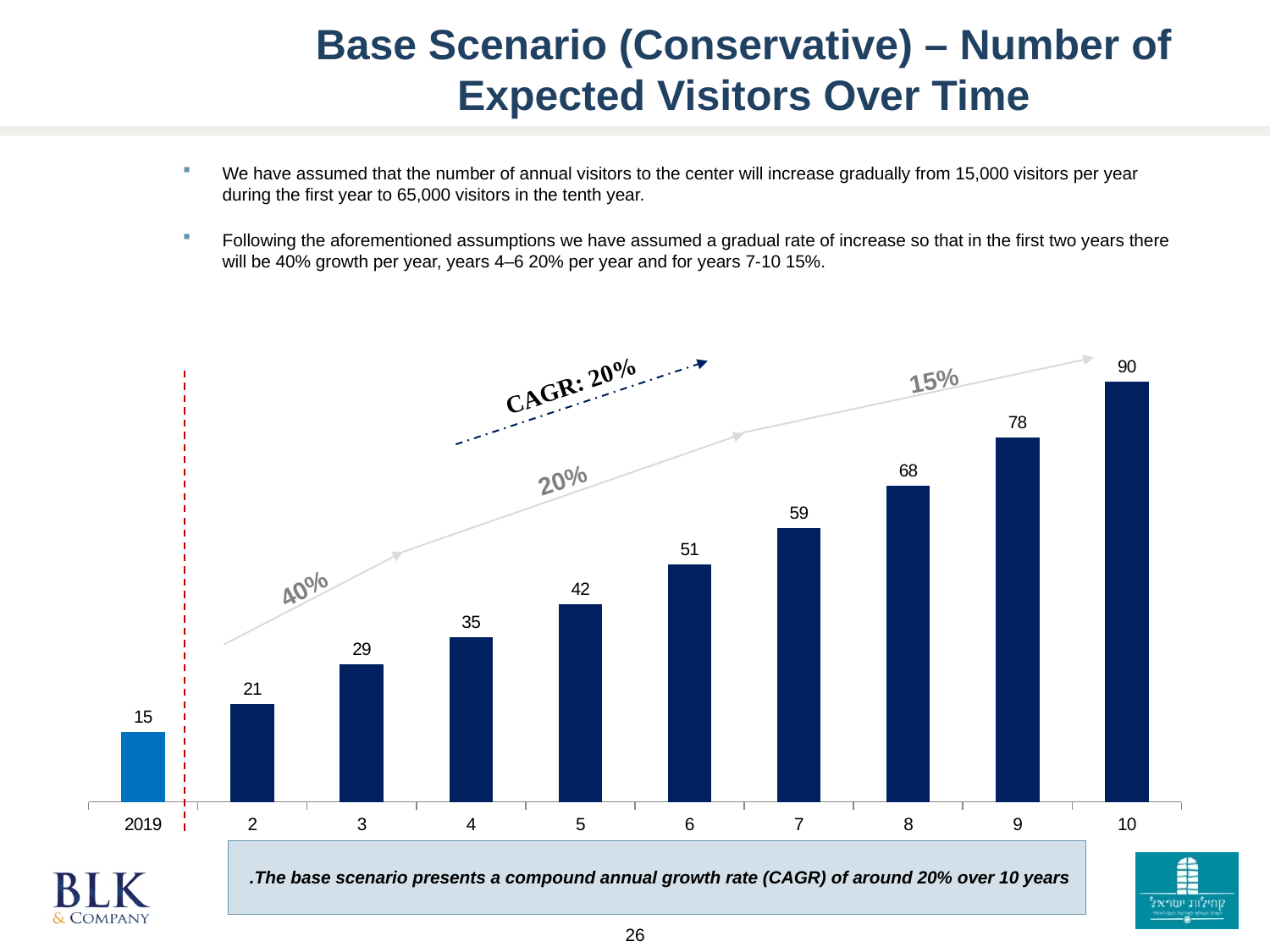
What is the value shown for year 8? 68 What CAGR is labelled on the chart? 20% Do the values rise or fall from 2019 to year 10? rise Which is larger, the value for year 4 or the value for year 3? year 4 What is the difference between the values for year 7 and year 6? 8 What kind of chart is shown on the slide? bar chart How many bars are shown in the chart? 10 What is the value shown for year 2019? 15 Which year has the lowest value? 2019 What is the difference between the values for year 10 and year 2019? 75 Which year has the highest value? 10 What is the value shown for year 5? 42